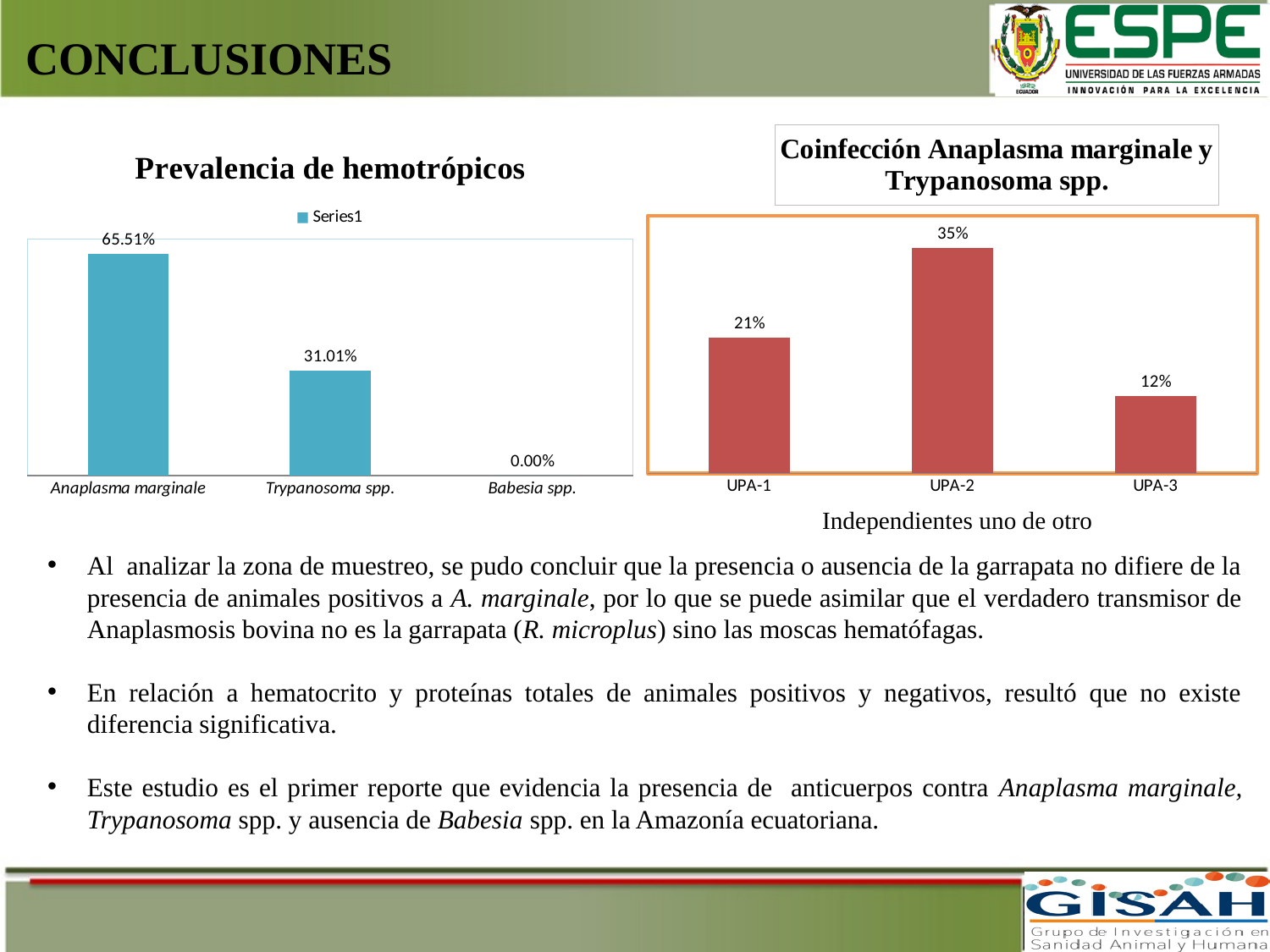
In the 'Coinfección Anaplasma marginale y Trypanosoma spp.' chart, what is the difference between UPA-2 and UPA-1? 14% In the 'Prevalencia de hemotrópicos' chart, what is the value for Anaplasma marginale? 65.51% In the 'Prevalencia de hemotrópicos' chart, how many series does the legend list? 1 In the 'Coinfección Anaplasma marginale y Trypanosoma spp.' chart, which is larger, UPA-1 or UPA-3? UPA-1 In the 'Prevalencia de hemotrópicos' chart, what is the value for Trypanosoma spp.? 31.01% In the 'Coinfección Anaplasma marginale y Trypanosoma spp.' chart, what is the value for UPA-2? 35% In the 'Prevalencia de hemotrópicos' chart, which category has the highest value? Anaplasma marginale In the 'Coinfección Anaplasma marginale y Trypanosoma spp.' chart, which UPA has the lowest value? UPA-3 In the 'Prevalencia de hemotrópicos' chart, what is the value for Babesia spp.? 0.00% In the 'Prevalencia de hemotrópicos' chart, how many categories are shown? 3 In the 'Prevalencia de hemotrópicos' chart, what is the difference between Anaplasma marginale and Trypanosoma spp.? 34.50% What type of chart is the 'Coinfección Anaplasma marginale y Trypanosoma spp.' chart? Bar chart